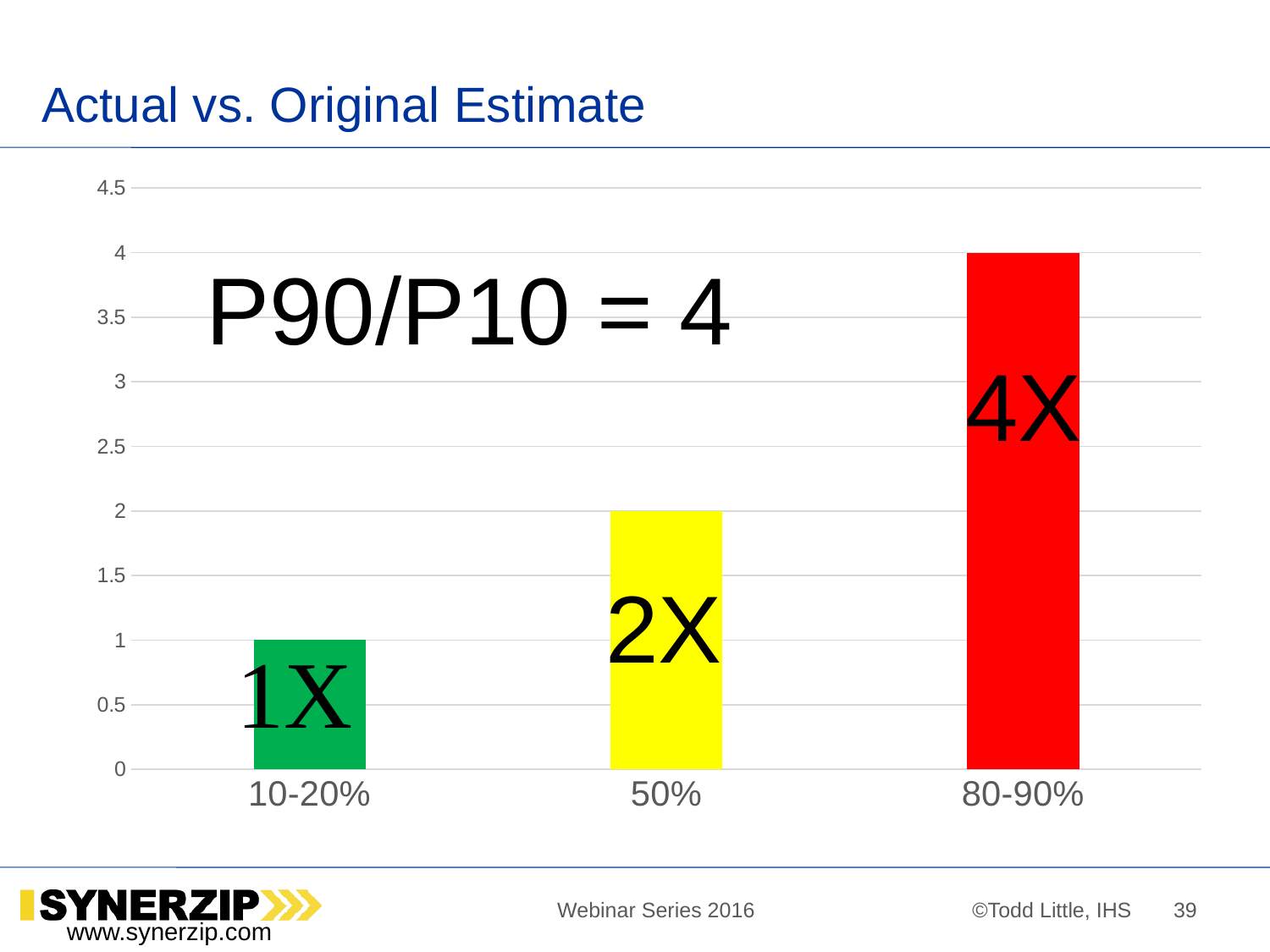
Which is larger, the value for 50% or the value for 80-90%? 80-90% Which category has the highest bar? 80-90% Which category has the lowest bar? 10-20% What is the difference between the value for 80-90% and the value for 10-20%? 3 What kind of chart is shown on the slide? bar chart What is the label on the bar for the 50% category? 2X What colour is the bar for the 50% category? yellow What is the label on the bar for the 10-20% category? 1X What is the label on the bar for the 80-90% category? 4X How many categories are shown on the x axis? 3 Do the bar values rise or fall from left to right along the x axis? rise What is the title of the chart? Actual vs. Original Estimate